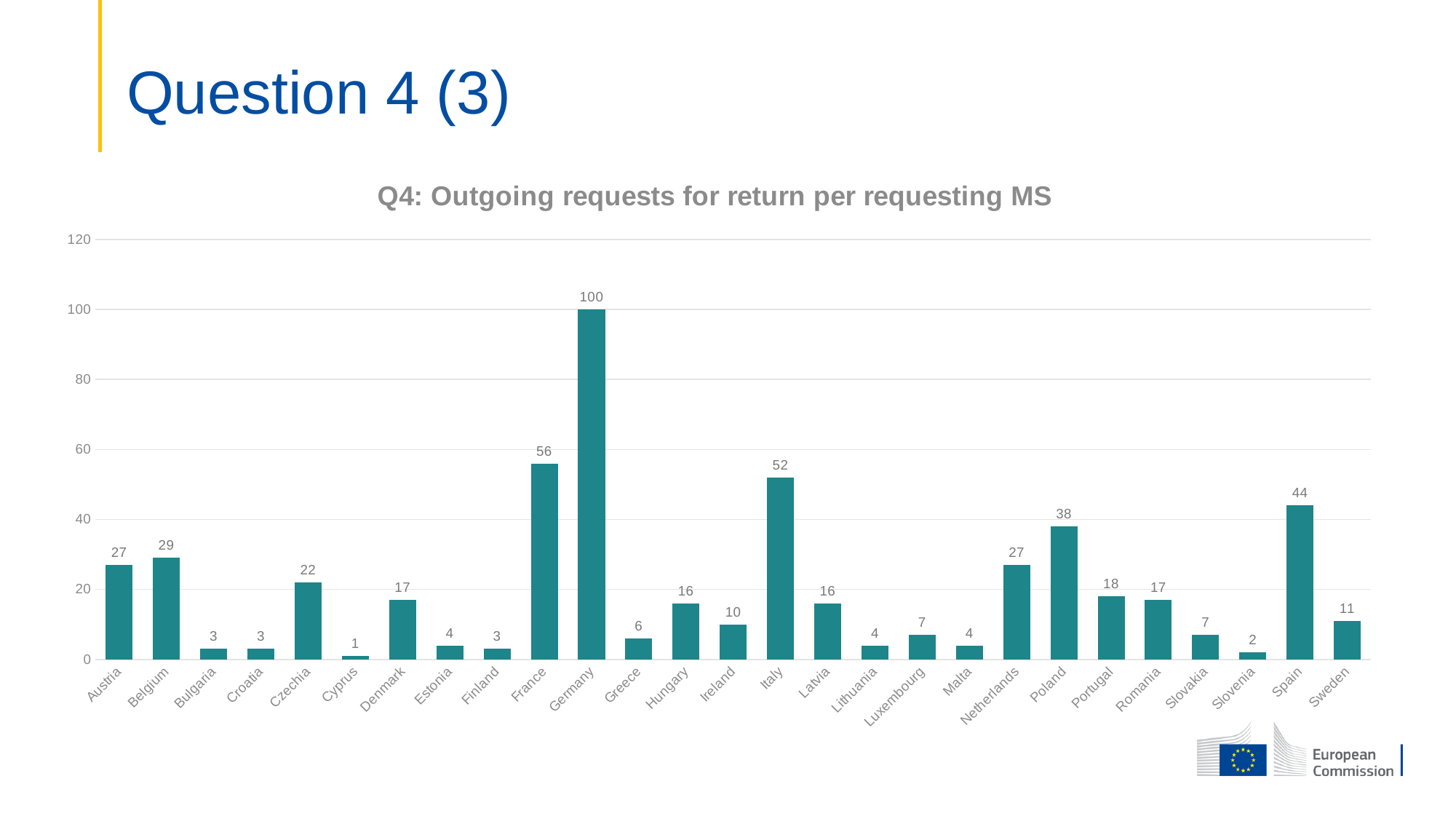
What is the title of the chart? Q4: Outgoing requests for return per requesting MS Which country has the highest value? Germany What is the value for Luxembourg? 7 What kind of chart is shown? bar chart Is the value for Spain greater or less than 40? greater Which is larger, the value for Czechia or the value for Portugal? Czechia What is the value for Poland? 38 What is the difference between the values for Spain and Belgium? 15 How many countries are shown on the x axis? 27 What is the difference between the values for France and Italy? 4 Which country has the lowest value? Cyprus What is the value for Germany? 100